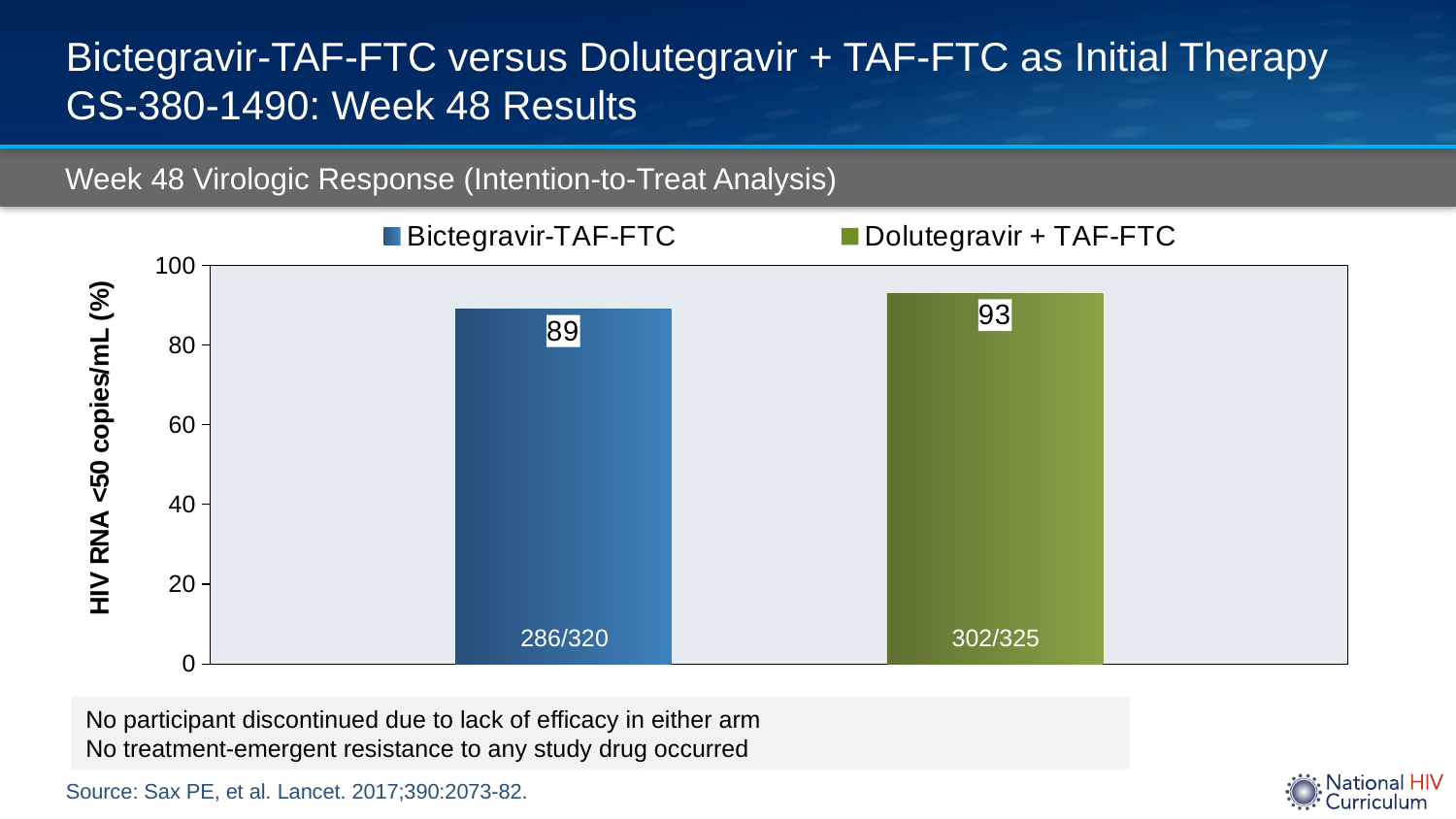
What is the value for Dolutegravir + TAF-FTC? 93 What is the value for Bictegravir-TAF-FTC? 89 What is the difference between the Dolutegravir + TAF-FTC value and the Bictegravir-TAF-FTC value? 4 Is the value for Bictegravir-TAF-FTC greater or less than 80? greater Which is larger, the value for Bictegravir-TAF-FTC or the value for Dolutegravir + TAF-FTC? Dolutegravir + TAF-FTC How many bars are plotted in the chart? 2 How many series does the legend list? 2 Which series has the highest value? Dolutegravir + TAF-FTC Which series has the lowest value? Bictegravir-TAF-FTC What is the y-axis label of the chart? HIV RNA <50 copies/mL (%) What kind of chart is shown? bar chart What fraction is printed on the Bictegravir-TAF-FTC bar? 286/320